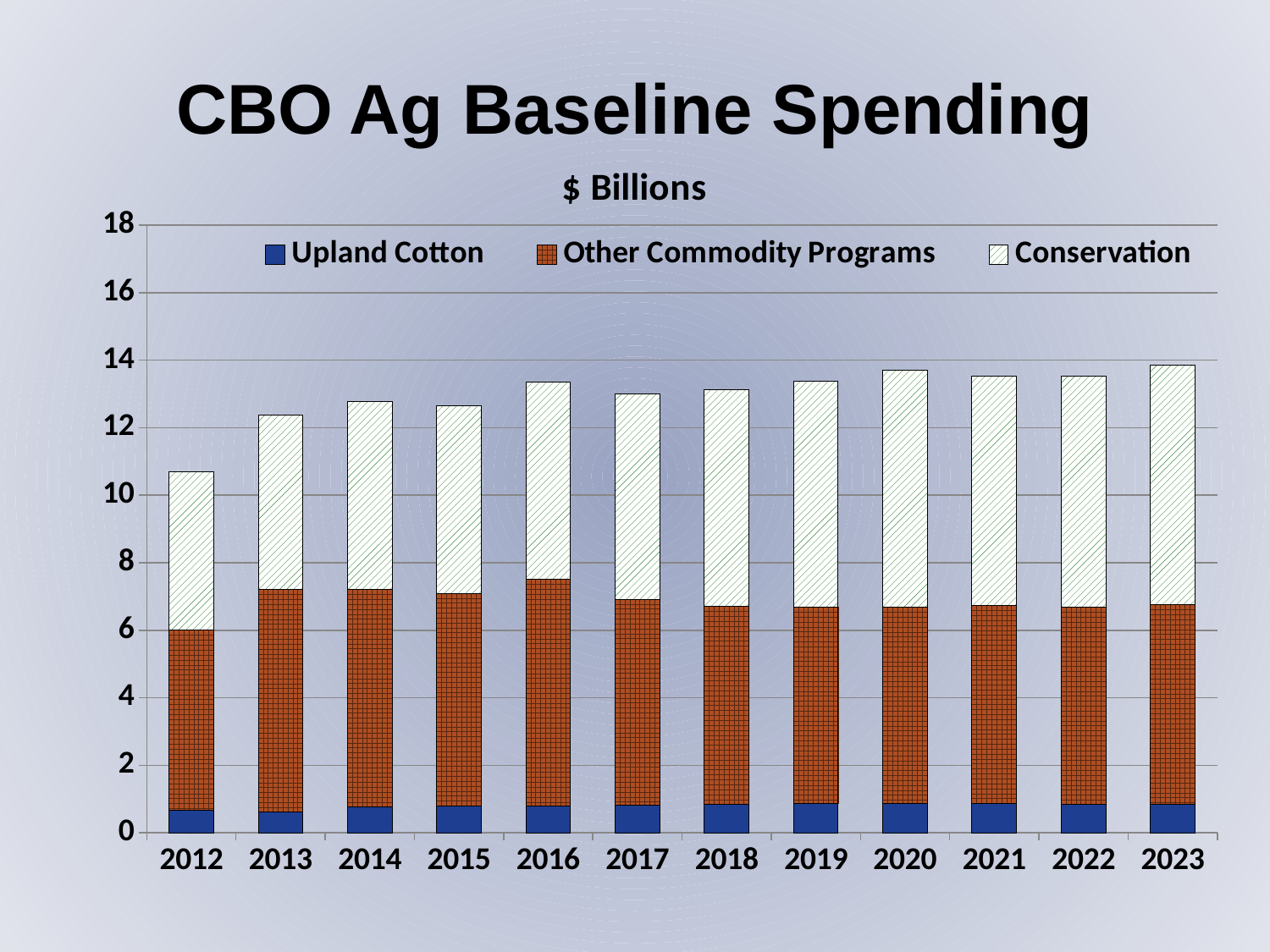
What unit is shown above the chart? $ Billions Is the total spending for 2012 greater or less than 12? less Is the total spending for 2016 greater or less than 14? less What kind of chart is shown on the slide? Stacked bar chart What is the title of the chart on the slide? CBO Ag Baseline Spending How many years are shown on the x axis of the chart? 12 Is the total spending for 2023 greater or less than 12? greater Does total spending generally rise or fall from 2012 to 2023? rise Which year has the lowest total spending in the chart? 2012 How many series does the chart's legend list? 3 Which year has the larger total spending, 2012 or 2013? 2013